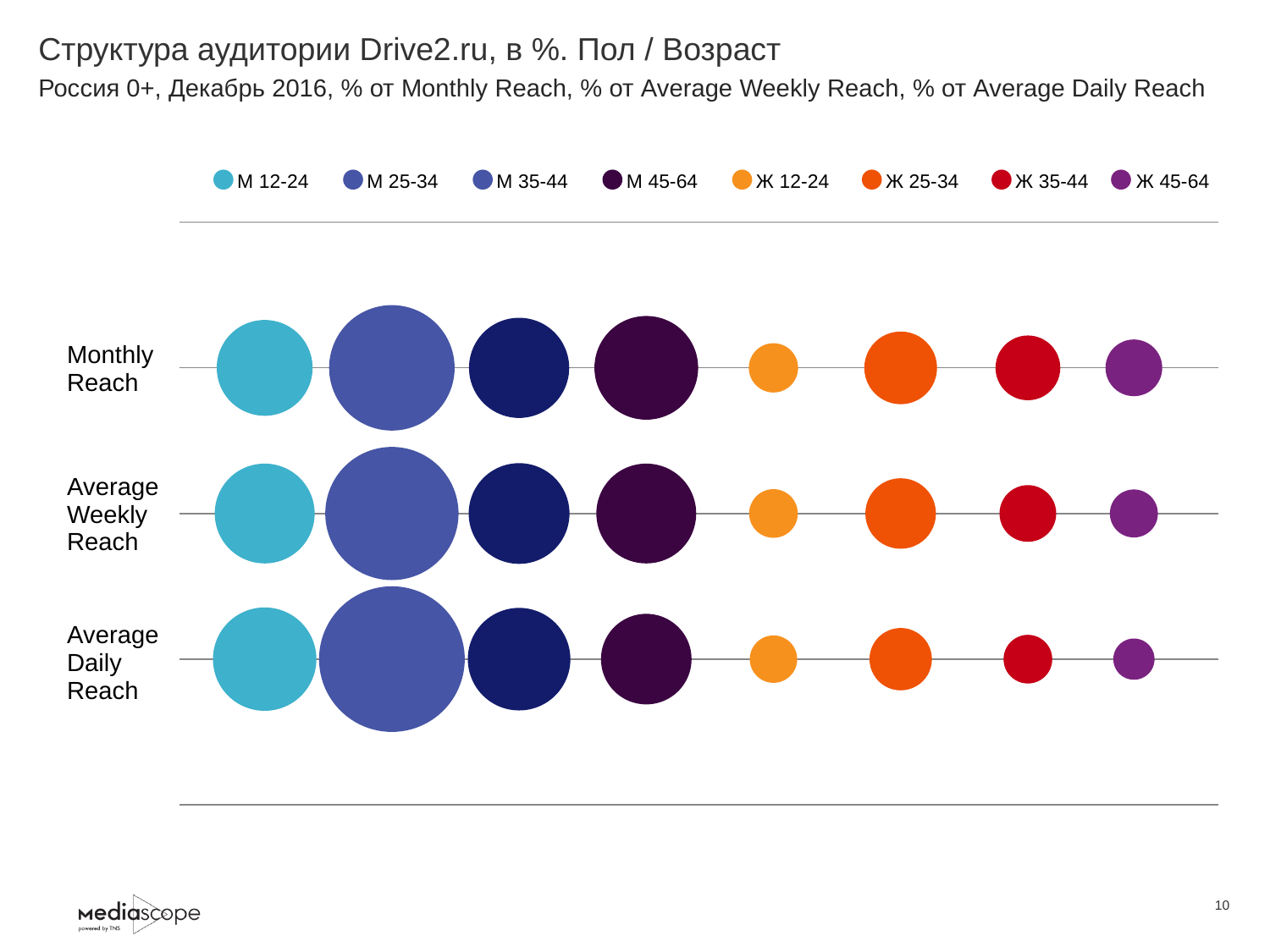
How many reach categories (rows) are plotted on the chart? 3 Which audience group has the smallest bubble in the Average Daily Reach row? Ж 45-64 What kind of chart is shown on the slide? bubble chart Which audience group has the largest bubble in the Monthly Reach row? М 25-34 In the Average Weekly Reach row, which bubble is larger: М 25-34 or Ж 12-24? М 25-34 Which audience group has the largest bubble in the Average Daily Reach row? М 25-34 In the Monthly Reach row, which bubble is larger: М 45-64 or Ж 35-44? М 45-64 In the Average Daily Reach row, which bubble is larger: М 12-24 or Ж 25-34? М 12-24 How many series does the legend list? 8 Does the М 25-34 bubble grow or shrink going from Monthly Reach to Average Daily Reach? grows Does the Ж 45-64 bubble grow or shrink going from Monthly Reach to Average Daily Reach? shrinks Which website's audience structure is shown in the chart title? Drive2.ru